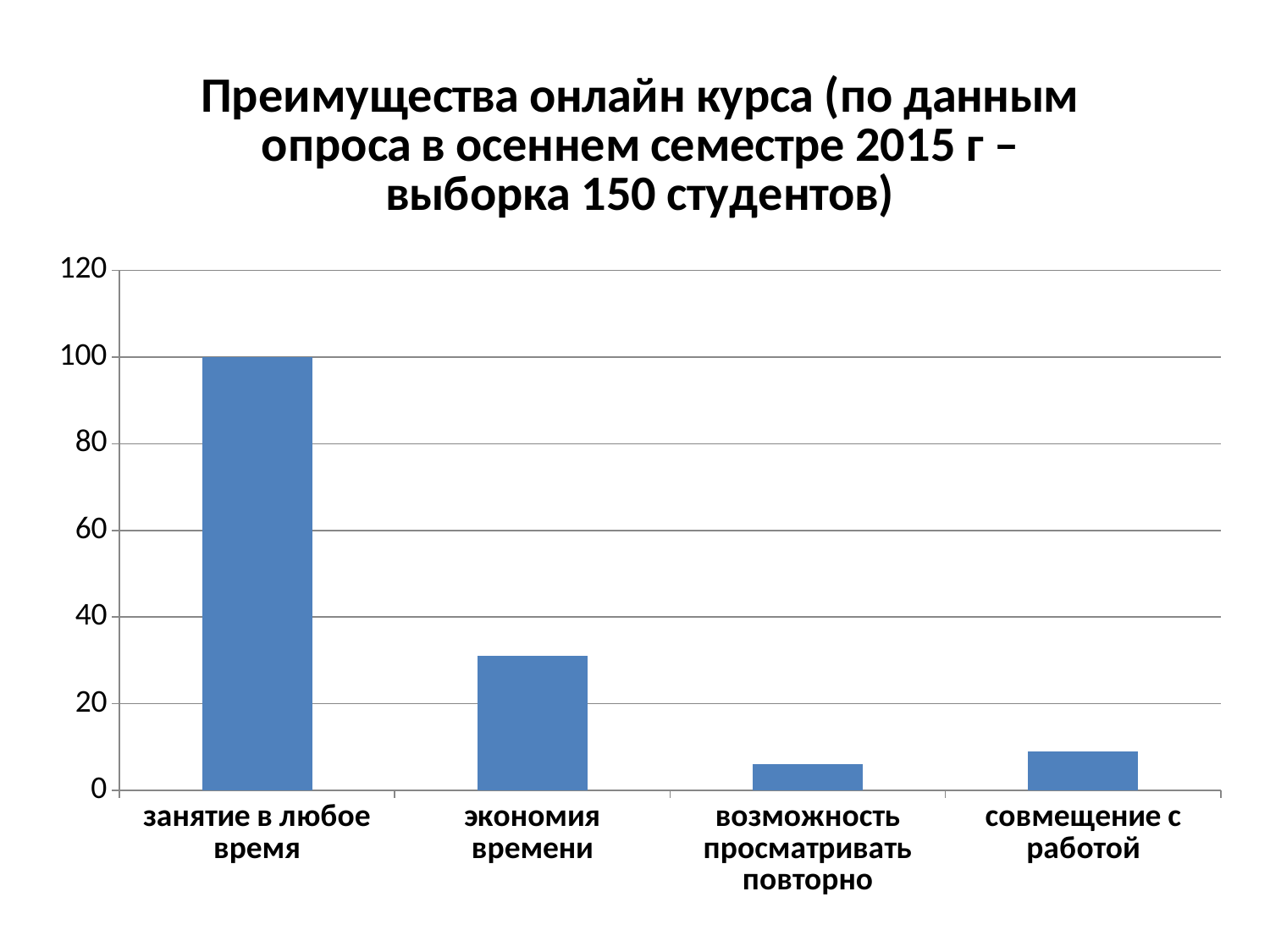
Which is larger, the value for "совмещение с работой" or the value for "возможность просматривать повторно"? совмещение с работой Is the value for "экономия времени" greater or less than 20? greater Which category has the highest bar? занятие в любое время What is the maximum value shown on the vertical axis of the chart? 120 Which is larger, the value for "экономия времени" or the value for "совмещение с работой"? экономия времени What is the value for "занятие в любое время"? 100 Is the value for "экономия времени" greater or less than 40? less Which category has the lowest bar? возможность просматривать повторно Is the value for "возможность просматривать повторно" greater or less than 20? less How many categories are shown on the x axis of the chart? 4 What kind of chart is shown on the slide? bar chart